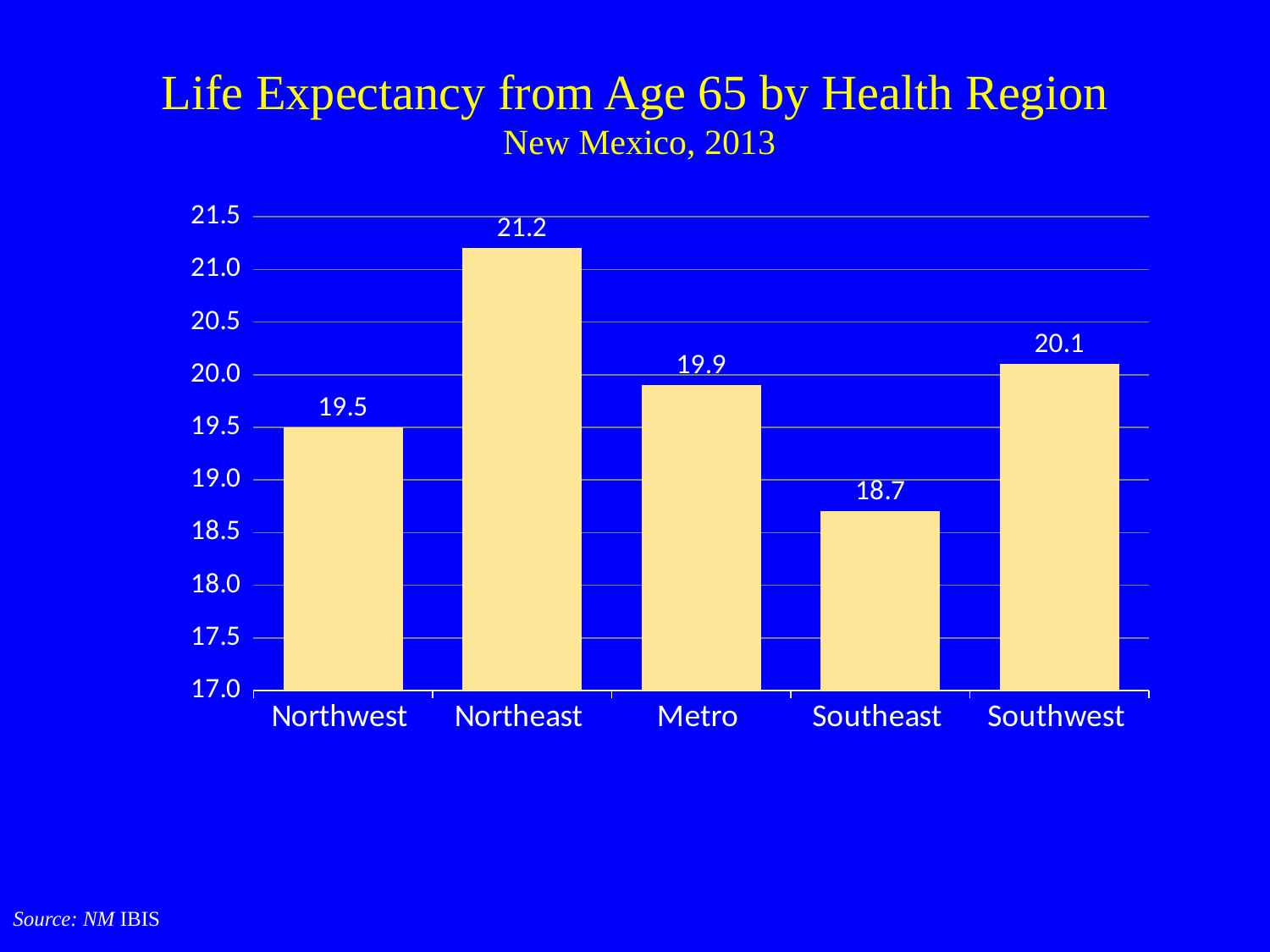
What is the difference between the Northeast and Southeast values? 2.5 Which health region has the highest life expectancy from age 65? Northeast What is the value shown for the Metro region? 19.9 What is the difference between the Southwest and Northwest values? 0.6 How many health regions are shown on the chart? 5 Which health region has the lowest life expectancy from age 65? Southeast What kind of chart is shown on the slide? Bar chart Which region has a higher value, Metro or Southwest? Southwest What is the source cited for the chart? NM IBIS Is the value for Northwest greater or less than 20.0? less What is the life expectancy from age 65 for the Northeast region? 21.2 What is the life expectancy from age 65 for the Southeast region? 18.7